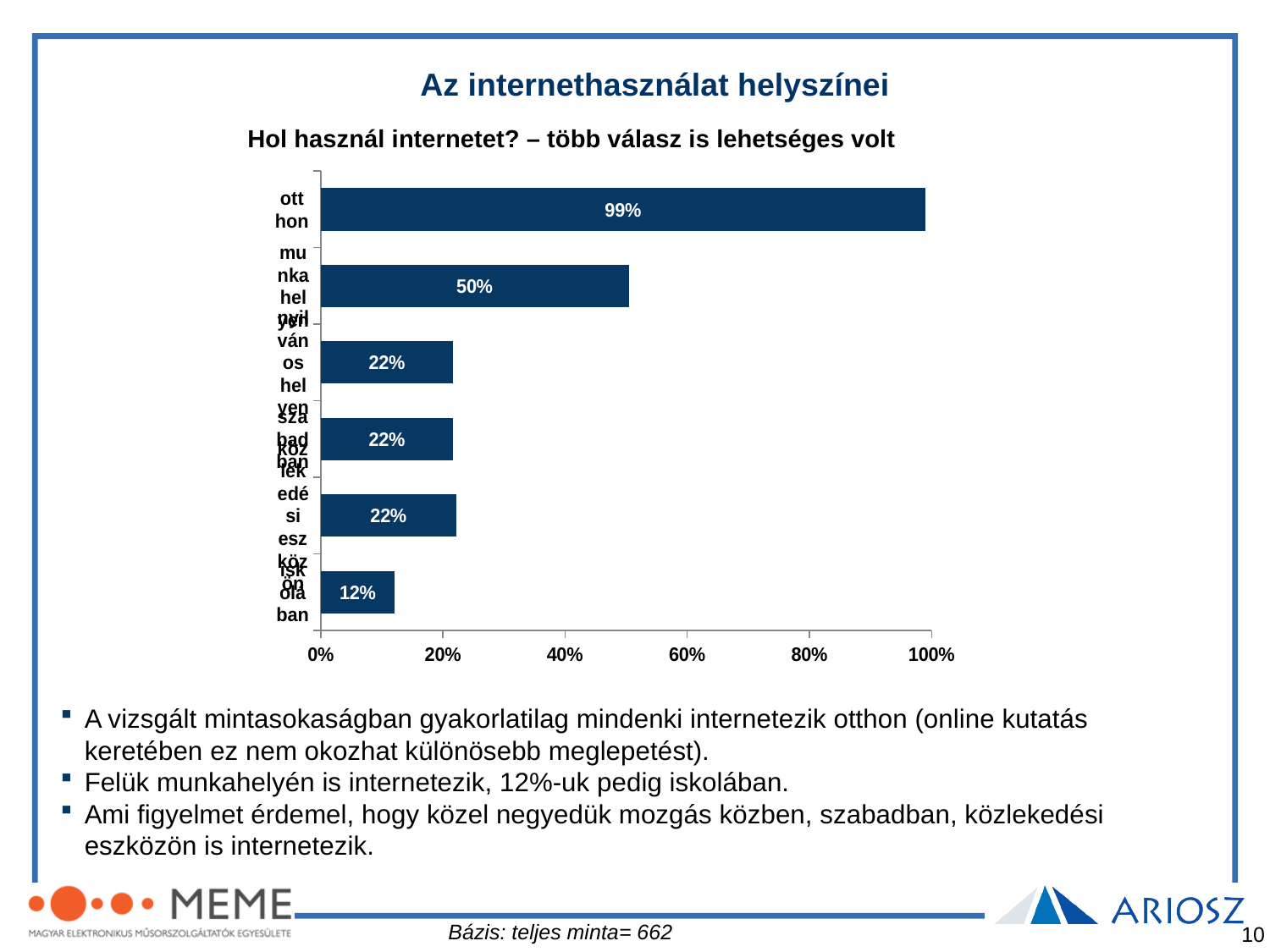
How many bars (categories) does the chart show? 6 Which is larger, the value for munkahelyen or the value for iskolában? munkahelyen What value is shown on the third bar from the top? 22% What is the difference between the value for otthon and the value for munkahelyen? 49% What is the difference between the value for munkahelyen and the value for iskolában? 38% What is the value shown for the workplace (munkahelyen) bar? 50% Which category has the lowest value in the chart? iskolában Is the value for munkahelyen greater or less than 40%? greater Which category has the highest value in the chart? otthon What percentage of respondents use the internet at home (otthon)? 99% What kind of chart is shown on the slide? bar chart What percentage is shown for using the internet at school (iskolában)? 12%